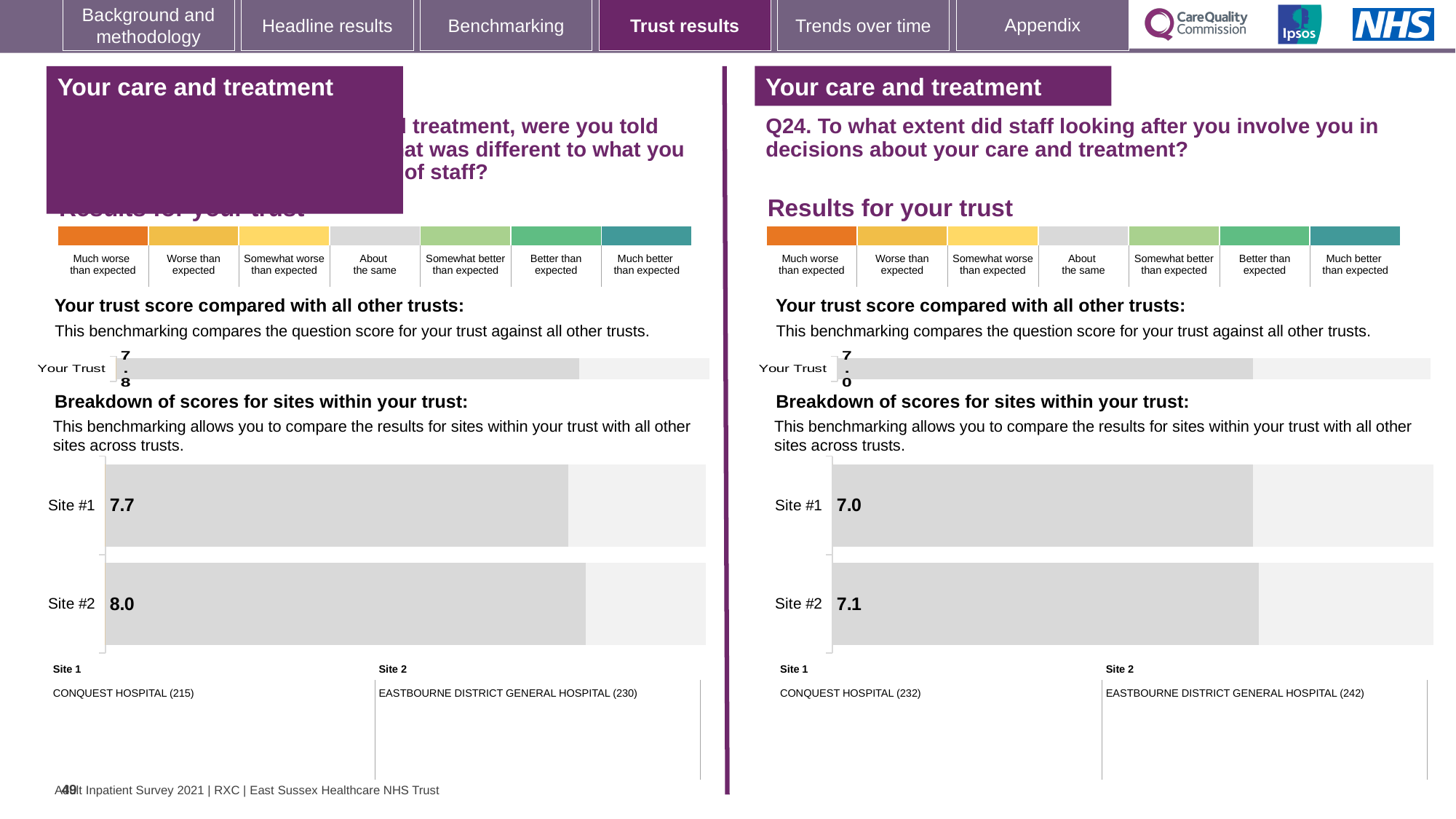
In the left-hand panel's site breakdown chart, what is the difference between the Site #2 and Site #1 scores? 0.3 In the left-hand panel, what is the score for Site #1 in the breakdown of scores for sites within your trust? 7.7 In the right-hand panel (Q24), what is the score for Site #1 in the breakdown of scores for sites within your trust? 7.0 In the right-hand panel (Q24), which hospital is listed as Site 2? EASTBOURNE DISTRICT GENERAL HOSPITAL (242) What type of chart is used for the breakdown of scores for sites within your trust in the left-hand panel? Bar chart In the left-hand panel's site breakdown chart, which site has the higher score? Site #2 In the right-hand panel (Q24), what is the score for Site #2 in the breakdown of scores for sites within your trust? 7.1 In the right-hand panel (Q24), what is the difference between the Site #2 and Site #1 scores? 0.1 In the left-hand panel, what is the 'Your Trust' score shown in the trust benchmarking bar? 7.8 In the left-hand panel, what is the score for Site #2 in the breakdown of scores for sites within your trust? 8.0 In the right-hand panel (Q24), what is the 'Your Trust' score shown in the trust benchmarking bar? 7.0 How many sites are shown in the site breakdown chart in the right-hand panel (Q24)? 2